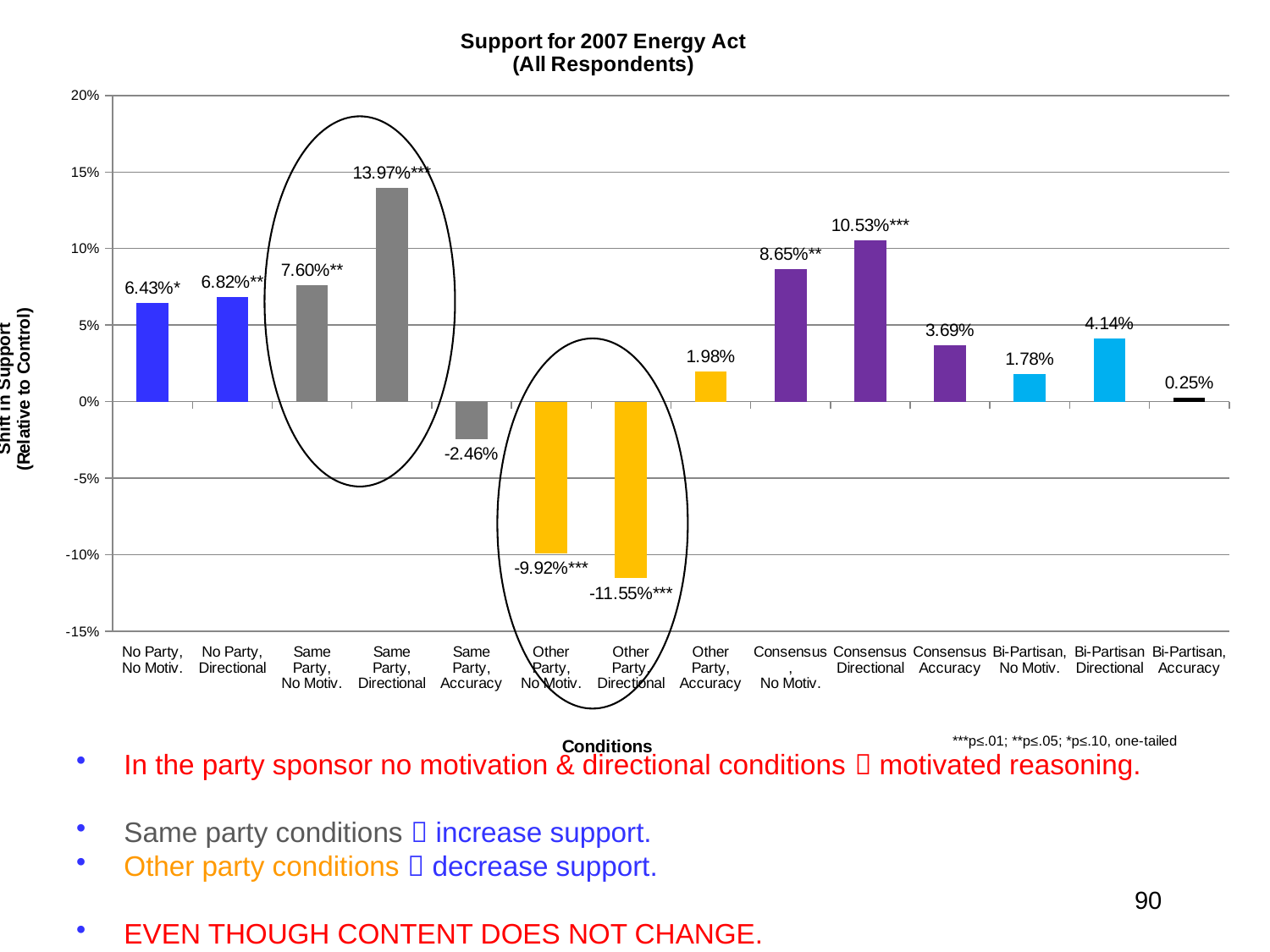
How many conditions (categories) are plotted on the x axis? 14 Is the shift in support for the Bi-Partisan, Accuracy condition greater or less than 5%? less What is the shift in support for the Same Party, Directional condition? 13.97%*** What is the difference between the shift in support for Same Party, Directional (13.97%) and Same Party, No Motiv. (7.60%)? 6.37% What is the label of the y axis? Shift in Support (Relative to Control) Which is larger, the shift in support for Consensus, No Motiv. or for Consensus, Directional? Consensus, Directional What type of chart is shown on the slide? Bar chart Which condition has the highest shift in support? Same Party, Directional What is the title of the chart? Support for 2007 Energy Act (All Respondents) What is the shift in support for the Consensus, Accuracy condition? 3.69% What is the shift in support for the Other Party, Directional condition? -11.55%*** Which condition has the lowest shift in support? Other Party, Directional